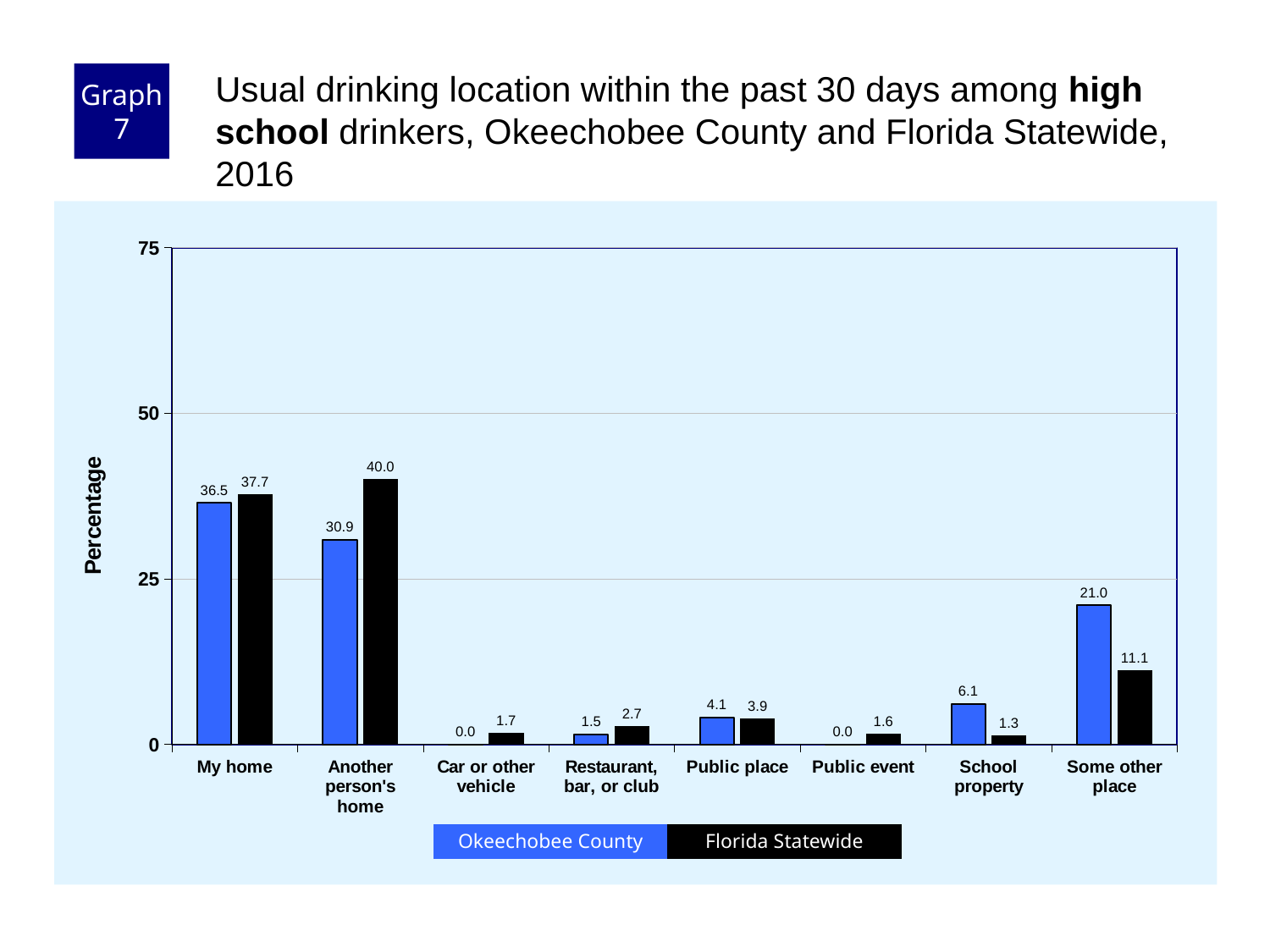
What is the difference between the Okeechobee County and Florida Statewide values for Some other place? 9.9 What is the Florida Statewide value for Another person's home? 40.0 What is the difference between the Florida Statewide and Okeechobee County values for Another person's home? 9.1 What kind of chart is shown? bar chart How many categories are shown on the x axis? 8 Which category has the highest Okeechobee County value? My home What is the Okeechobee County value for My home? 36.5 What is the Okeechobee County value for Some other place? 21.0 Is the Florida Statewide value for My home greater or less than 50? less How many series does the legend list? 2 Which is larger for School property: Okeechobee County or Florida Statewide? Okeechobee County Which category has the highest Florida Statewide value? Another person's home